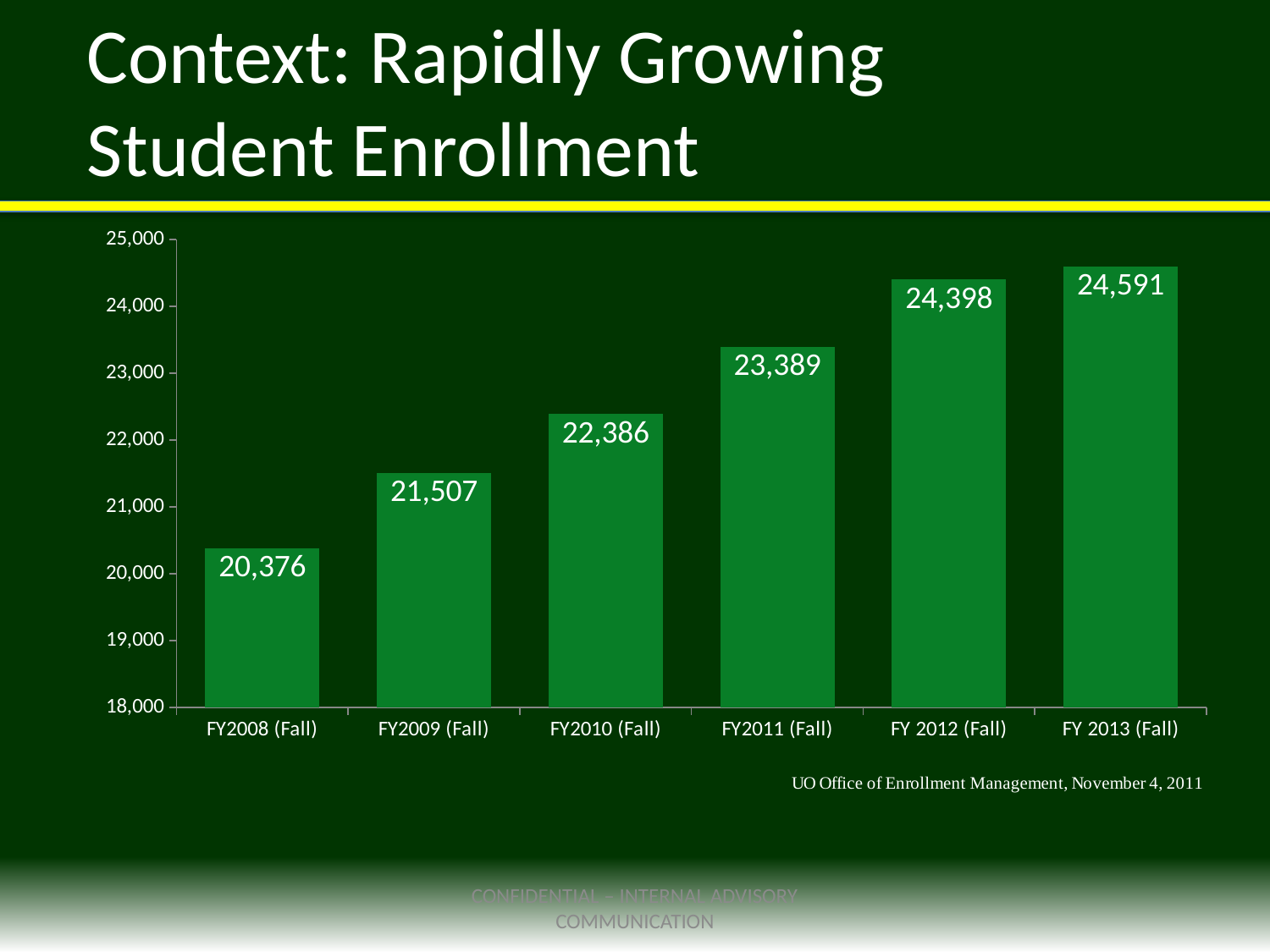
Which category has the highest value? FY 2013 (Fall) What is the difference between the values for FY2011 (Fall) and FY2010 (Fall)? 1,003 What is the title of the slide containing the chart? Context: Rapidly Growing Student Enrollment Which is larger, the value for FY2009 (Fall) or the value for FY2011 (Fall)? FY2011 (Fall) How many categories are shown on the x axis? 6 Is the value for FY2009 (Fall) greater or less than 21,000? greater What is the difference between the values for FY 2013 (Fall) and FY2008 (Fall)? 4,215 Do the values rise or fall from FY2008 (Fall) to FY 2013 (Fall)? rise What is the enrollment value for FY 2012 (Fall)? 24,398 What kind of chart is shown on the slide? bar chart What is the enrollment value for FY2010 (Fall)? 22,386 Which category has the lowest value? FY2008 (Fall)